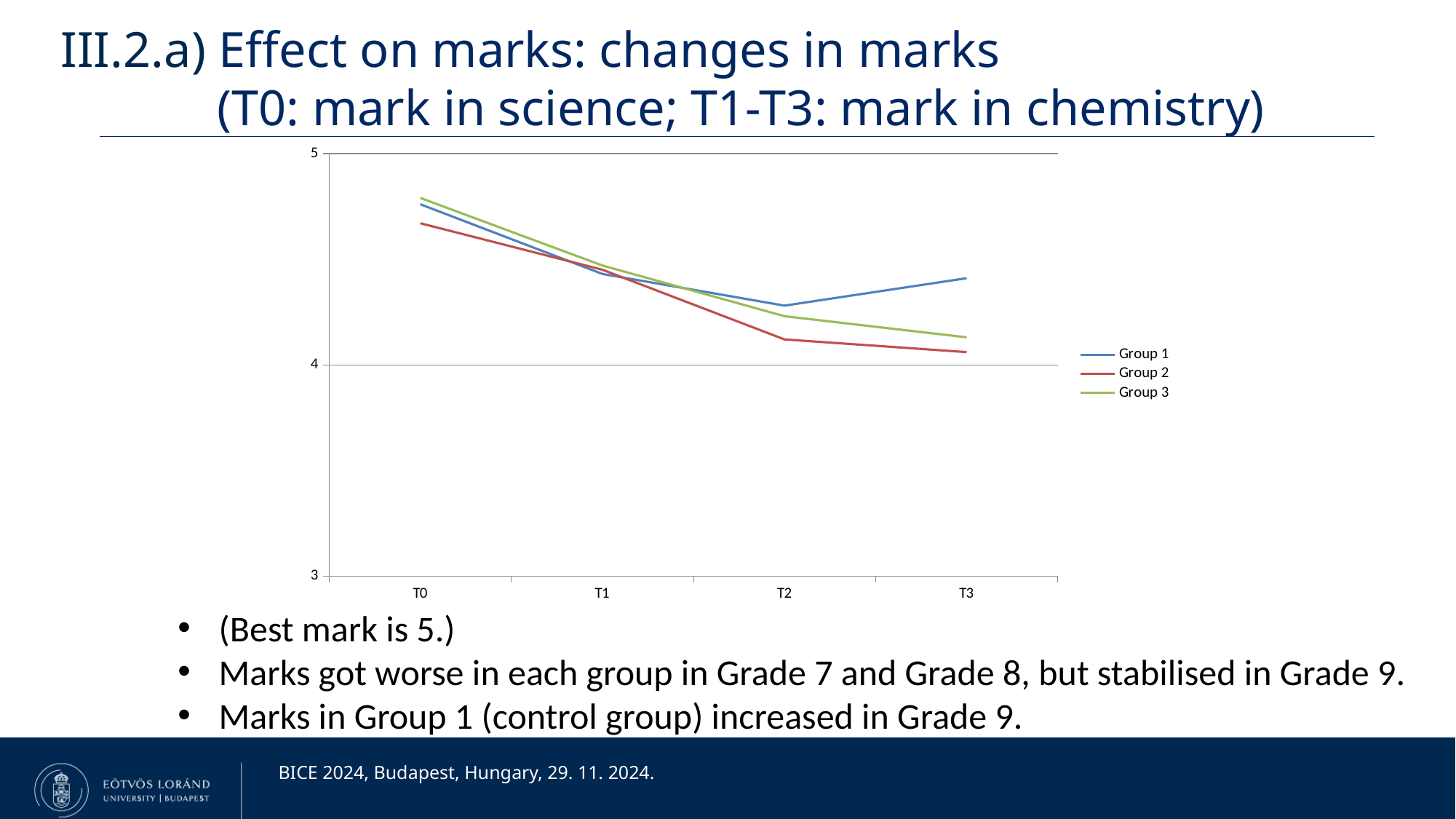
At T3, is the mark for Group 1 larger or smaller than the mark for Group 2? larger At T0, is the mark for Group 3 larger or smaller than the mark for Group 2? larger Which group has the lowest mark at T2? Group 2 What kind of chart is shown on the slide? line chart Is the value for Group 2 at T3 greater or less than 4? greater Is the value for Group 1 at T0 greater or less than 5? less How many series does the legend list? 3 What colour is the line for Group 1? blue Which group has the highest mark at T3? Group 1 Do the marks for Group 2 rise or fall from T0 to T3? fall How many time points are plotted along the x axis? 4 Between T2 and T3, do the marks for Group 1 rise or fall? rise